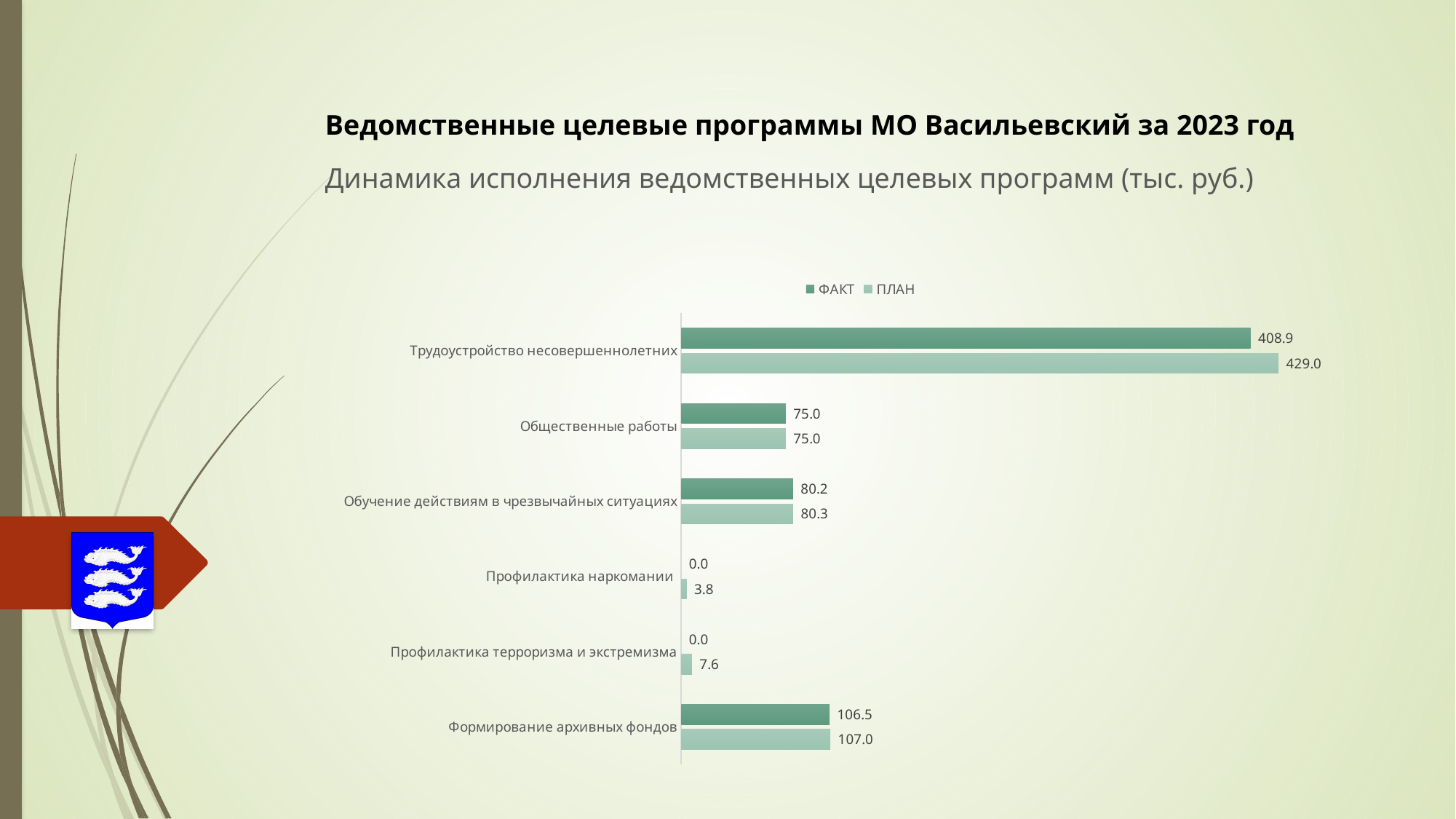
What is the ПЛАН value for Трудоустройство несовершеннолетних? 429.0 What is the ПЛАН value for Профилактика терроризма и экстремизма? 7.6 Which category has the lowest ПЛАН value? Профилактика наркомании What kind of chart is shown on the slide? Bar chart What is the ФАКТ value for Трудоустройство несовершеннолетних? 408.9 What is the ФАКТ value for Формирование архивных фондов? 106.5 How many categories are shown in the chart? 6 Which is larger for Формирование архивных фондов, the ФАКТ value or the ПЛАН value? ПЛАН What are the two series named in the legend? ФАКТ and ПЛАН How many series does the legend list? 2 Which category has the highest ПЛАН value? Трудоустройство несовершеннолетних What is the difference between the ПЛАН and ФАКТ values for Трудоустройство несовершеннолетних? 20.1